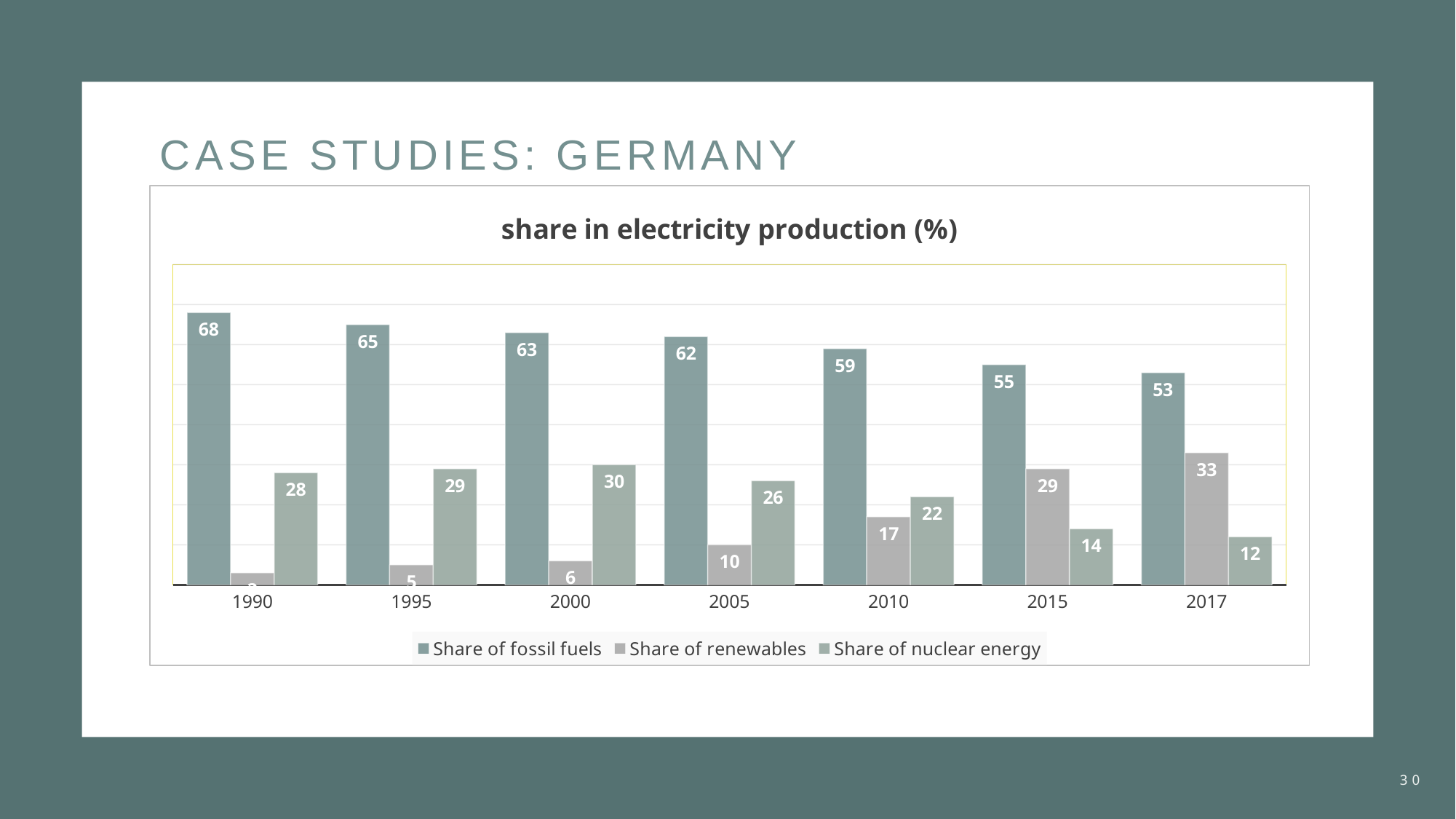
What is the share of renewables in 2017? 33 Does the share of fossil fuels rise or fall from 1990 to 2017? fall In 2015, which is larger: the share of renewables or the share of nuclear energy? Share of renewables In which year is the share of fossil fuels lowest? 2017 How many years are shown on the x axis? 7 In which year is the share of nuclear energy highest? 2000 What is the share of nuclear energy in 2000? 30 How many series does the legend list? 3 What is the difference between the share of fossil fuels in 1990 and in 2017? 15 What is the share of renewables in 2010? 17 What is the share of fossil fuels in 1990? 68 What type of chart is shown on the slide? bar chart